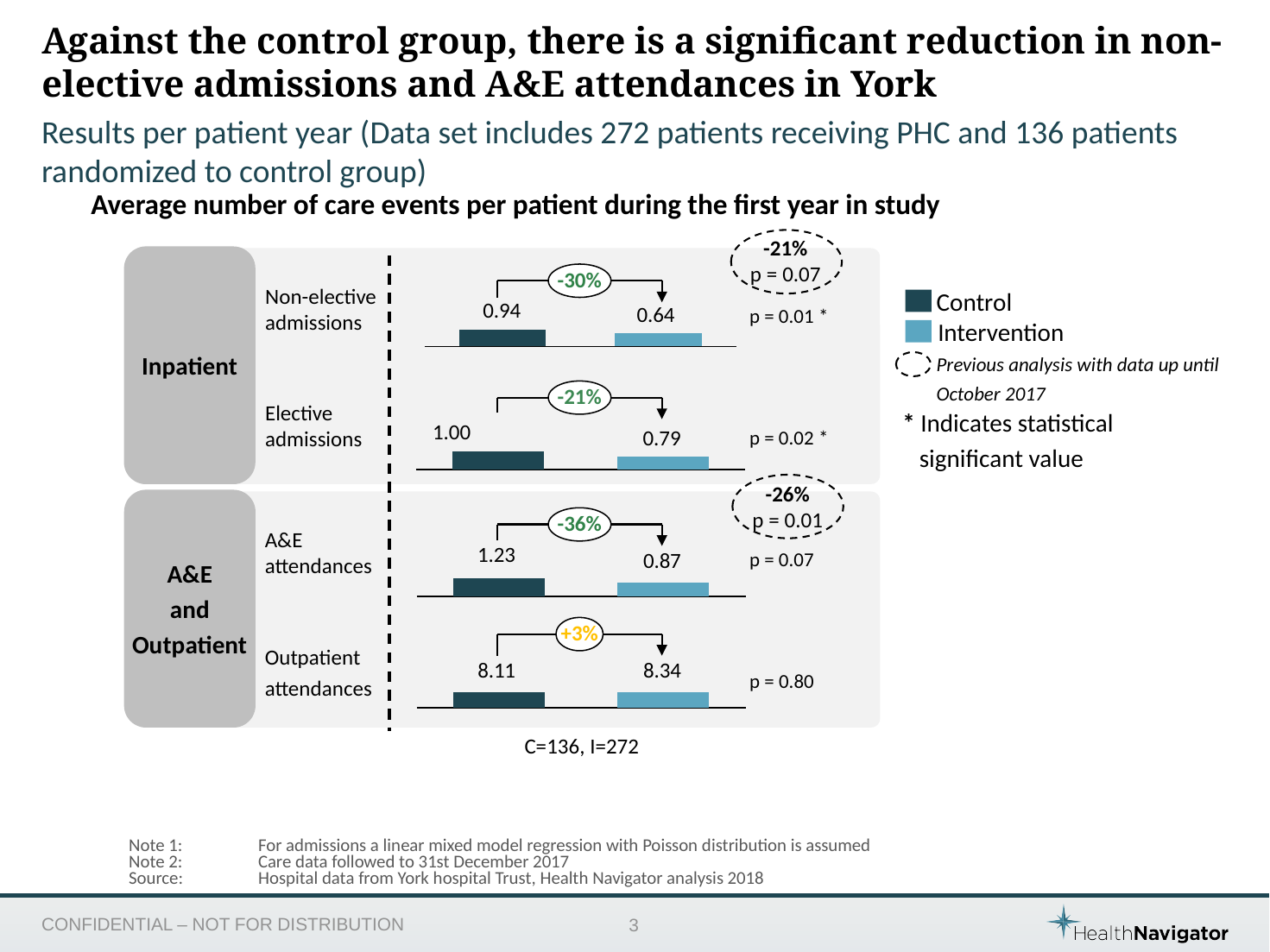
What is the difference between the Intervention and Control values for Outpatient attendances? 0.23 What is the Control value for Outpatient attendances? 8.11 Which category has the highest Control value? Outpatient attendances What is the Control value for Non-elective admissions? 0.94 What kind of chart is used to show the care events per patient? Bar chart What is the p-value shown for Outpatient attendances? p = 0.80 For Outpatient attendances, which is larger: the Control value or the Intervention value? Intervention How many series does the legend list? 2 What is the difference between the Control and Intervention values for Non-elective admissions? 0.30 What percentage change is shown for A&E attendances? -36% What is the Intervention value for A&E attendances? 0.87 What is the Intervention value for Elective admissions? 0.79